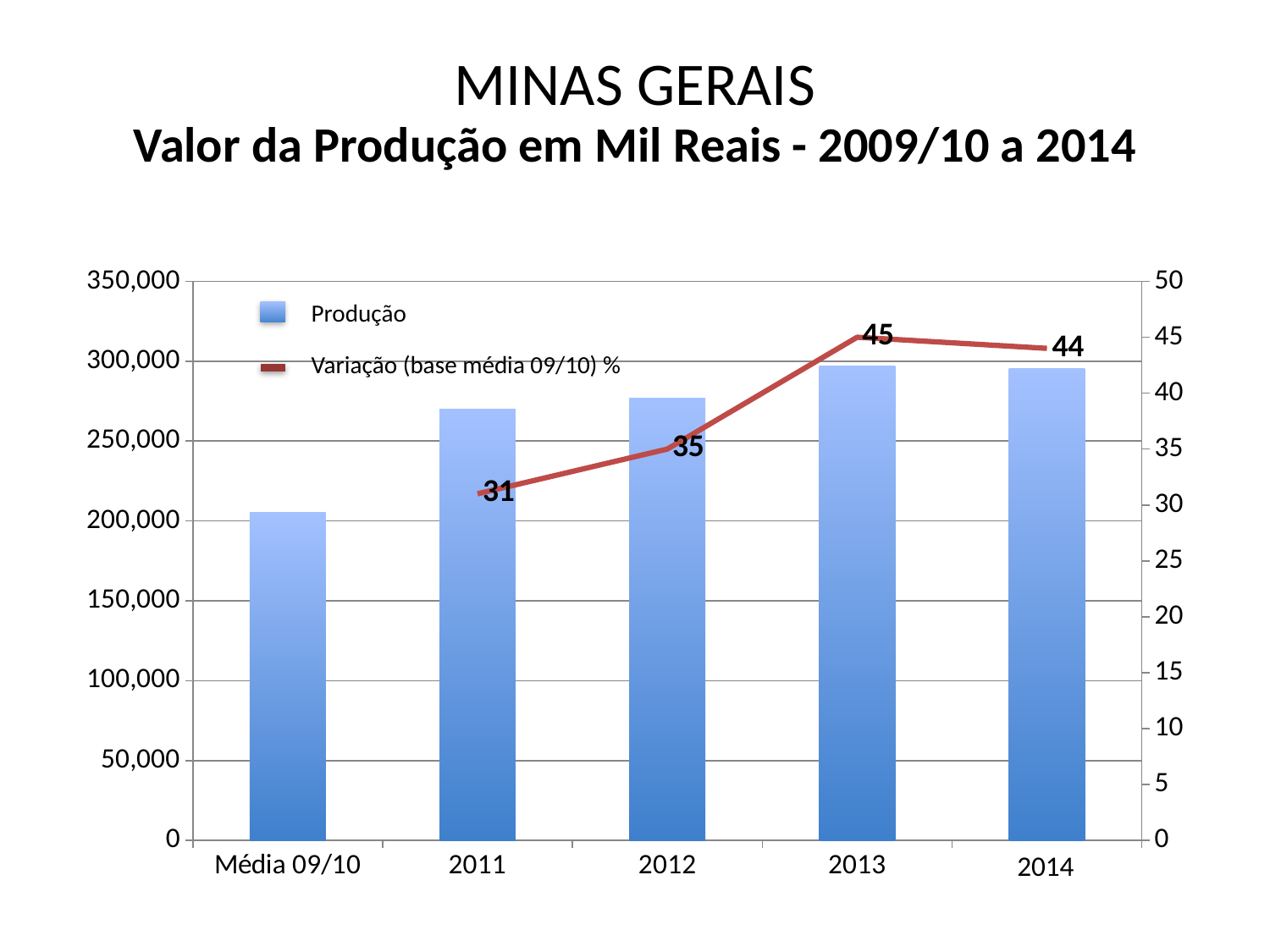
How many series does the legend list? 2 What is the value of Variação (base média 09/10) % for 2013? 45 Is the Produção value for Média 09/10 greater or less than 250,000? less What is the difference between the Variação (base média 09/10) % for 2013 and for 2011? 14 What is the value of Variação (base média 09/10) % for 2011? 31 Which is larger, the Produção bar for 2011 or for Média 09/10? 2011 Is the Produção value for 2013 greater or less than 250,000? greater What is the value of Variação (base média 09/10) % for 2014? 44 In which year is the Variação (base média 09/10) % lowest? 2011 Which category has the lowest Produção bar? Média 09/10 In which year is the Variação (base média 09/10) % highest? 2013 How many categories are shown on the x axis? 5